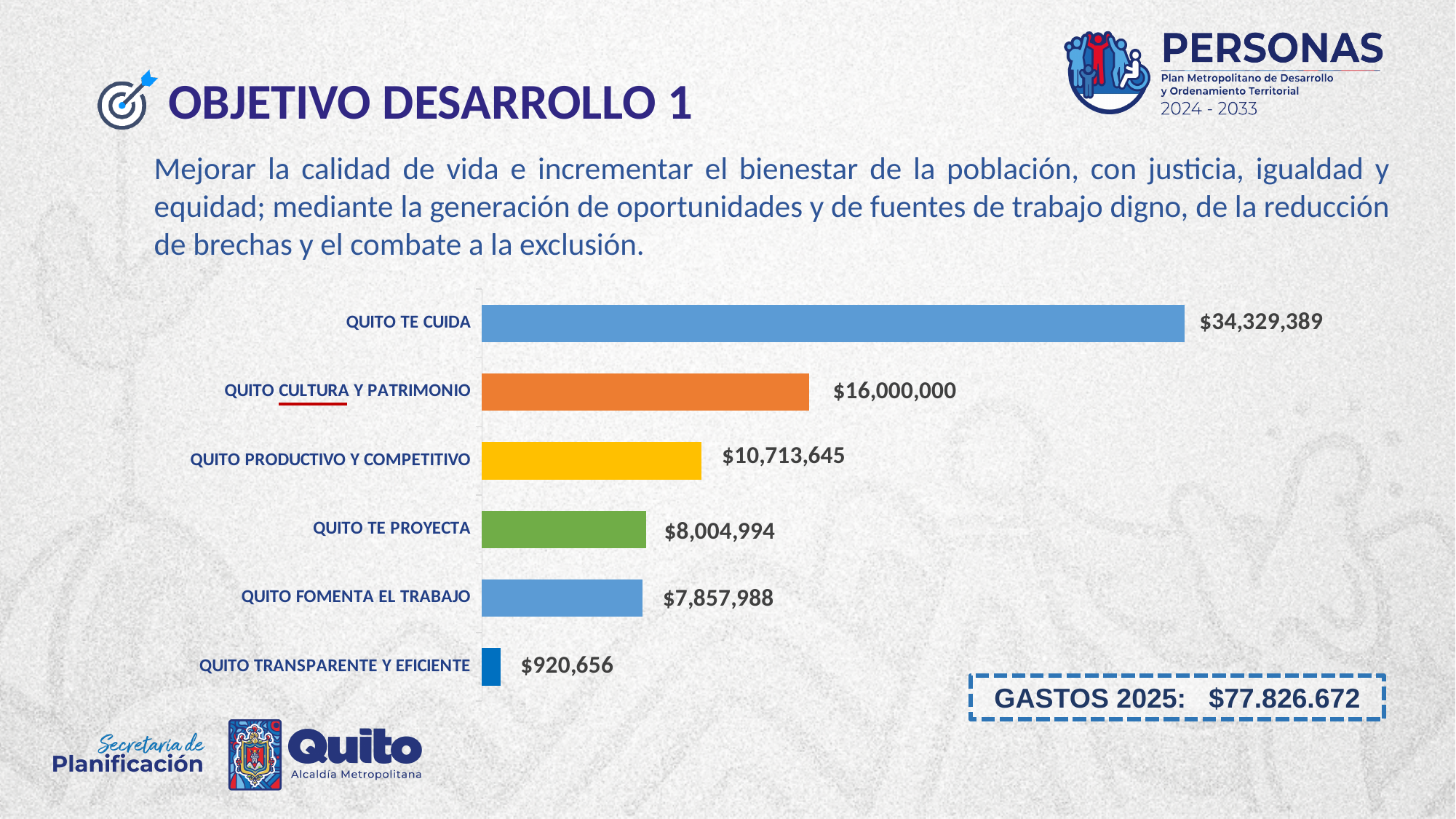
What is the value for QUITO PRODUCTIVO Y COMPETITIVO? $10,713,645 How many categories are shown in the chart? 6 What kind of chart is shown on the slide? Bar chart Which is larger, the value for QUITO TE PROYECTA or the value for QUITO FOMENTA EL TRABAJO? QUITO TE PROYECTA What colour is the bar for QUITO CULTURA Y PATRIMONIO? Orange What is the difference between the values for QUITO TE CUIDA and QUITO CULTURA Y PATRIMONIO? $18,329,389 Which category has the lowest value? QUITO TRANSPARENTE Y EFICIENTE What is the value for QUITO CULTURA Y PATRIMONIO? $16,000,000 What is the difference between the values for QUITO TE PROYECTA and QUITO FOMENTA EL TRABAJO? $147,006 What is the value for QUITO TE CUIDA? $34,329,389 Which category has the highest value? QUITO TE CUIDA What is the value for QUITO TRANSPARENTE Y EFICIENTE? $920,656